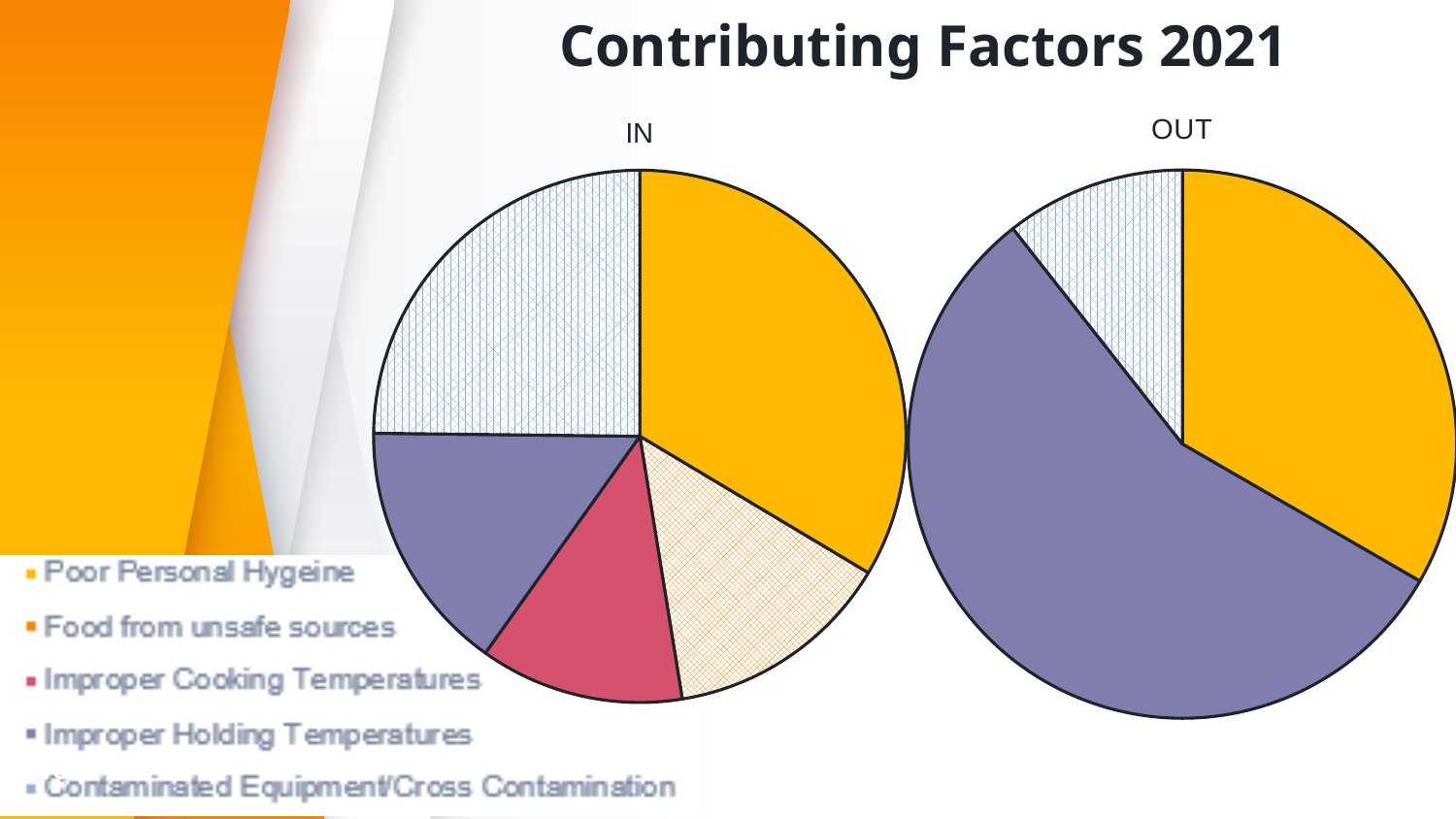
In the OUT pie chart, which is larger: Improper Holding Temperatures or Poor Personal Hygeine? Improper Holding Temperatures How many entries does the legend list? 5 In the IN pie chart, which category has the largest slice? Poor Personal Hygeine How many slices does the OUT pie chart have? 3 In the OUT pie chart, which category has the smallest slice? Contaminated Equipment/Cross Contamination How many slices does the IN pie chart have? 5 In the IN pie chart, which category has the smallest slice? Improper Cooking Temperatures What kind of chart is the IN chart? pie chart In the OUT pie chart, which category has the largest slice? Improper Holding Temperatures What kind of chart is the OUT chart? pie chart In the IN pie chart, which is larger: Contaminated Equipment/Cross Contamination or Improper Holding Temperatures? Contaminated Equipment/Cross Contamination What is the title of the slide containing the two pie charts? Contributing Factors 2021